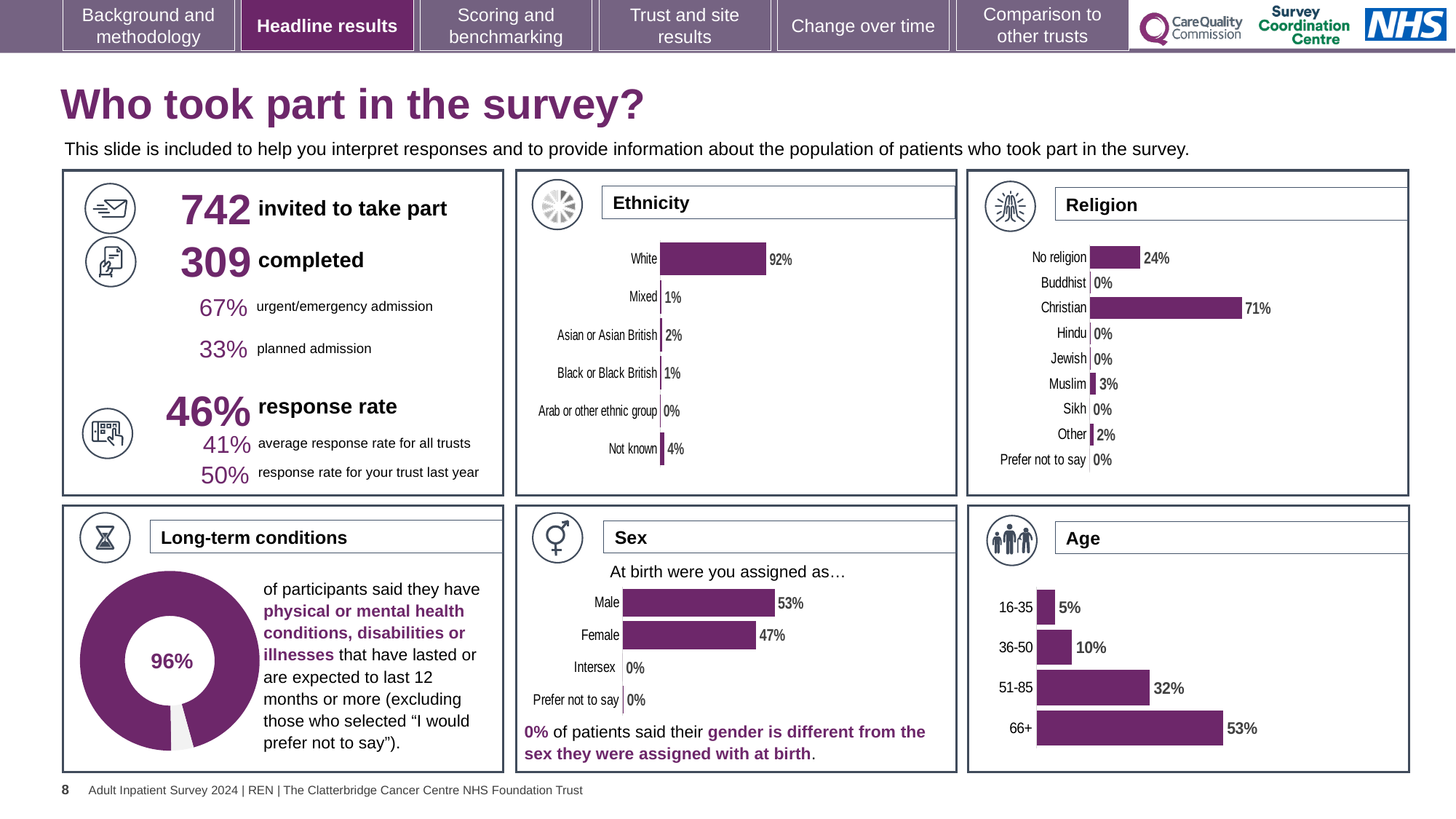
In the Sex chart, what is the difference between Male and Female? 6% In the Ethnicity chart, what percentage of respondents were White? 92% In the Age chart, do the values rise or fall as the age groups increase? rise In the Religion chart, what percentage of respondents were Christian? 71% In the Age chart, what percentage of respondents were aged 51-85? 32% In the Age chart, which age group has the lowest value? 16-35 In the Ethnicity chart, what is the value for Not known? 4% In the Sex chart, which is larger, Male or Female? Male In the Religion chart, what is the difference between Christian and No religion? 47% What kind of chart is used in the Long-term conditions panel? doughnut chart In the Ethnicity chart, which category has the highest value? White In the Religion chart, how many categories are shown? 9